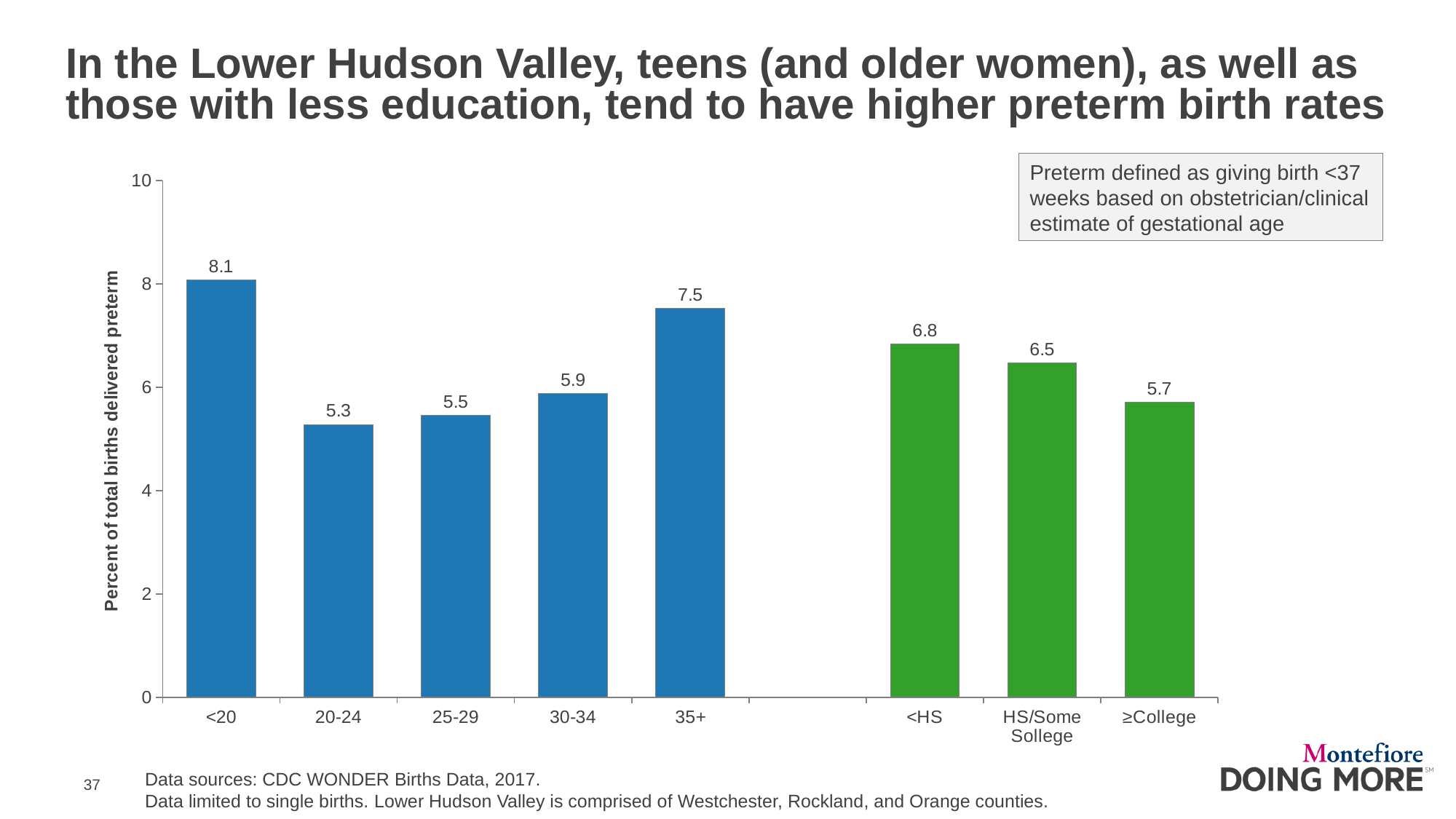
What is the difference between the preterm birth rate for <20 and for 20-24? 2.8 What is the label of the y axis? Percent of total births delivered preterm What is the value shown for the 35+ age group? 7.5 Which age group has the lowest percent of total births delivered preterm? 20-24 Is the value for HS/Some Sollege greater or less than 6? greater How many categories are shown on the x axis? 8 What kind of chart is shown on the slide? bar chart What is the difference between the preterm birth rate for <HS and for ≥College? 1.1 What is the percent of total births delivered preterm for the <HS education group? 6.8 What is the percent of total births delivered preterm for mothers aged <20? 8.1 Which category has the highest percent of total births delivered preterm? <20 Which is larger, the value for 35+ or the value for <HS? 35+